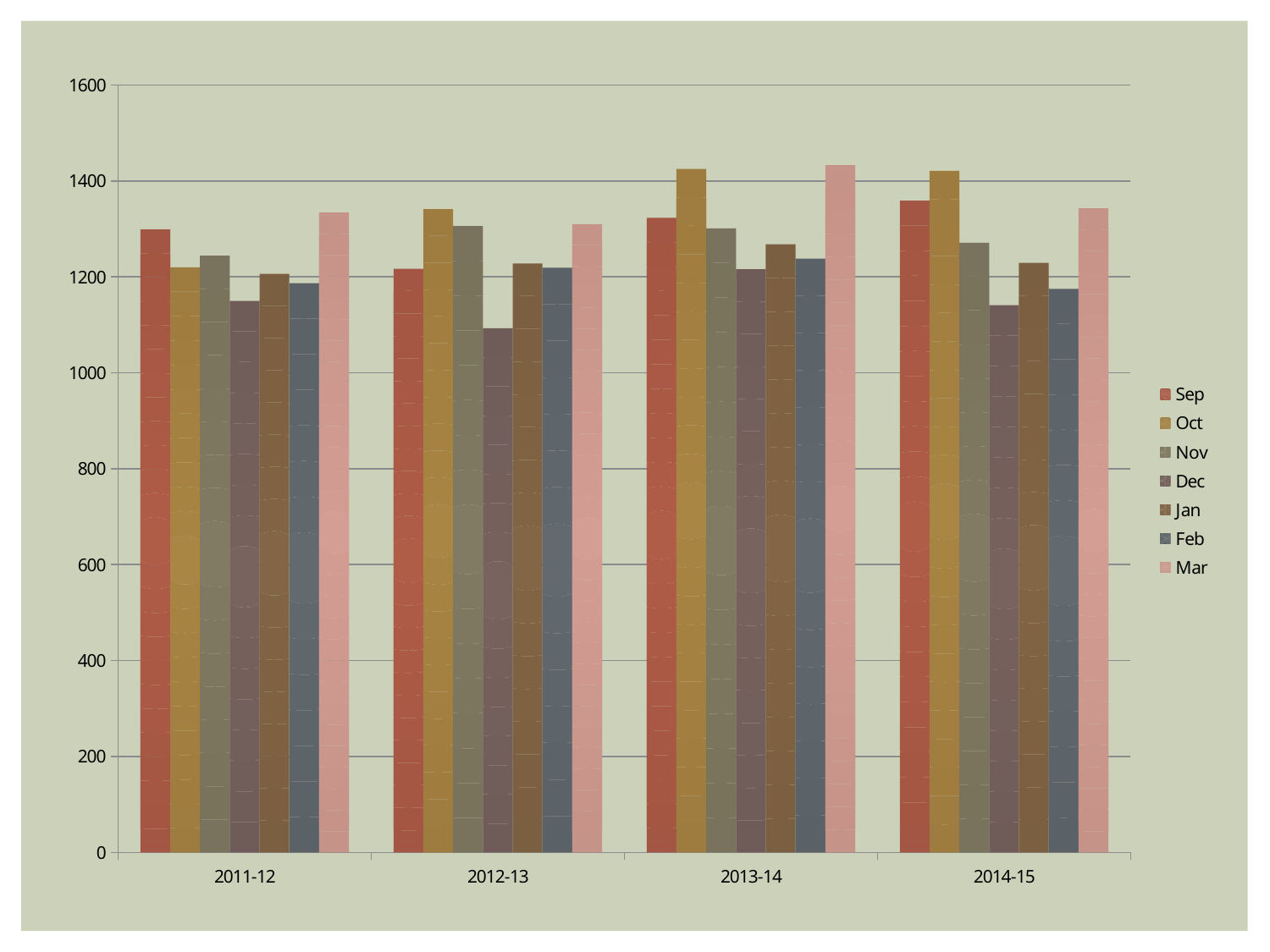
What kind of chart is shown on the slide? Bar chart Is the value for Dec in 2014-15 greater or less than 1200? less Which month has the lowest value in 2012-13? Dec Is the value for Dec in 2012-13 greater or less than 1200? less Is the value for Sep in 2011-12 greater or less than 1200? greater Which month has the highest value in 2014-15? Oct Which months are listed in the legend? Sep, Oct, Nov, Dec, Jan, Feb, Mar In 2013-14, which is larger, the value for Oct or the value for Dec? Oct In 2011-12, which is larger, the value for Mar or the value for Feb? Mar How many year categories are shown on the x axis? 4 How many series does the legend list? 7